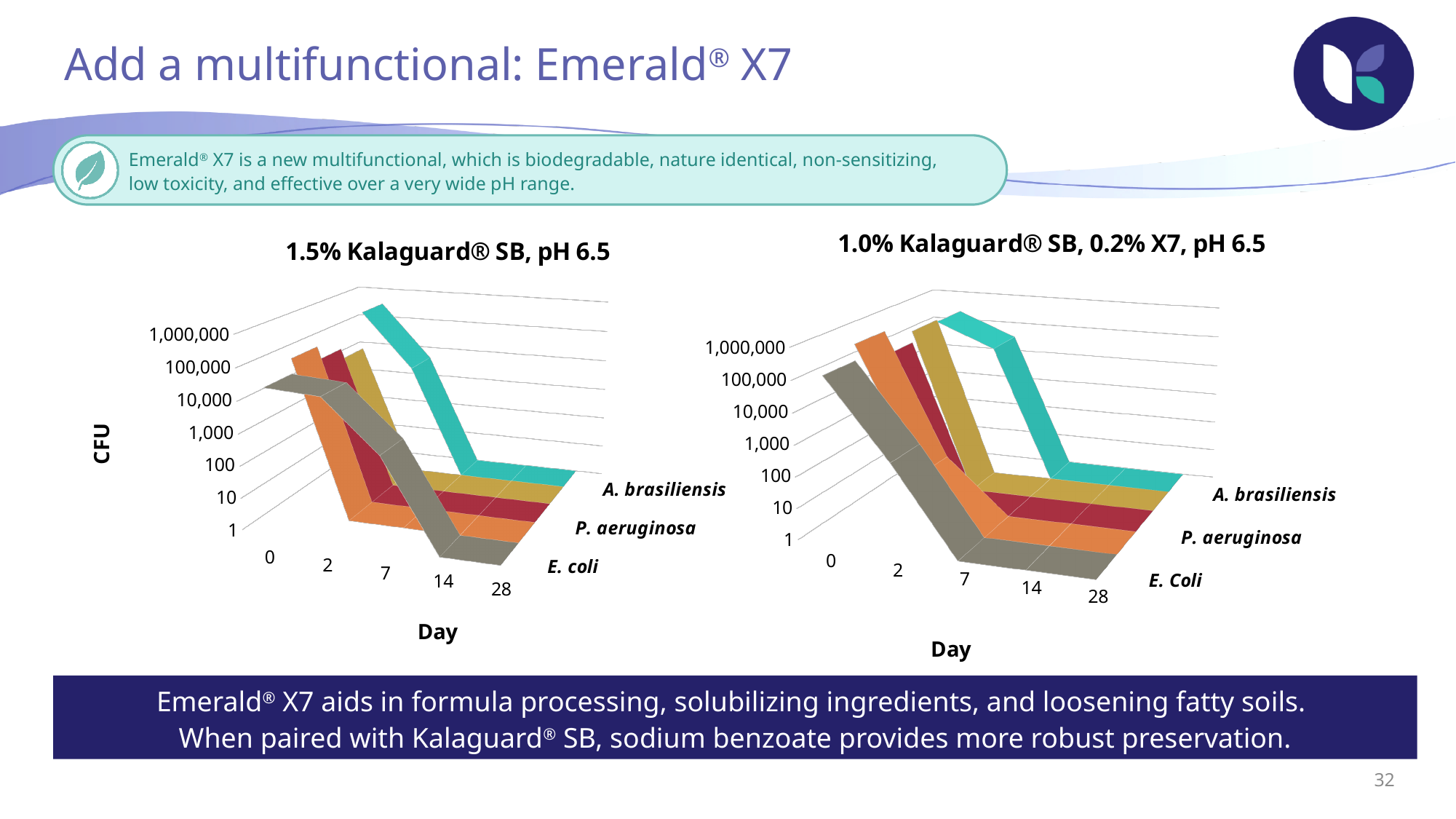
What is the title of the left chart? 1.5% Kalaguard® SB, pH 6.5 In the left chart, is the value for E. coli at day 0 greater or less than 1,000? greater In the right chart, how many day points are plotted along the x axis? 5 In the right chart, do the CFU values rise or fall from day 0 to day 28? fall In the left chart, what kind of chart is shown? 3D line chart In the left chart, what is the label on the vertical axis? CFU In the left chart, how many day points are plotted along the x axis? 5 In the right chart, what is the highest tick value shown on the CFU axis? 1,000,000 In the left chart, do the CFU values for A. brasiliensis rise or fall from day 0 to day 28? fall In the right chart, is the value for E. Coli at day 0 greater or less than 1,000? greater